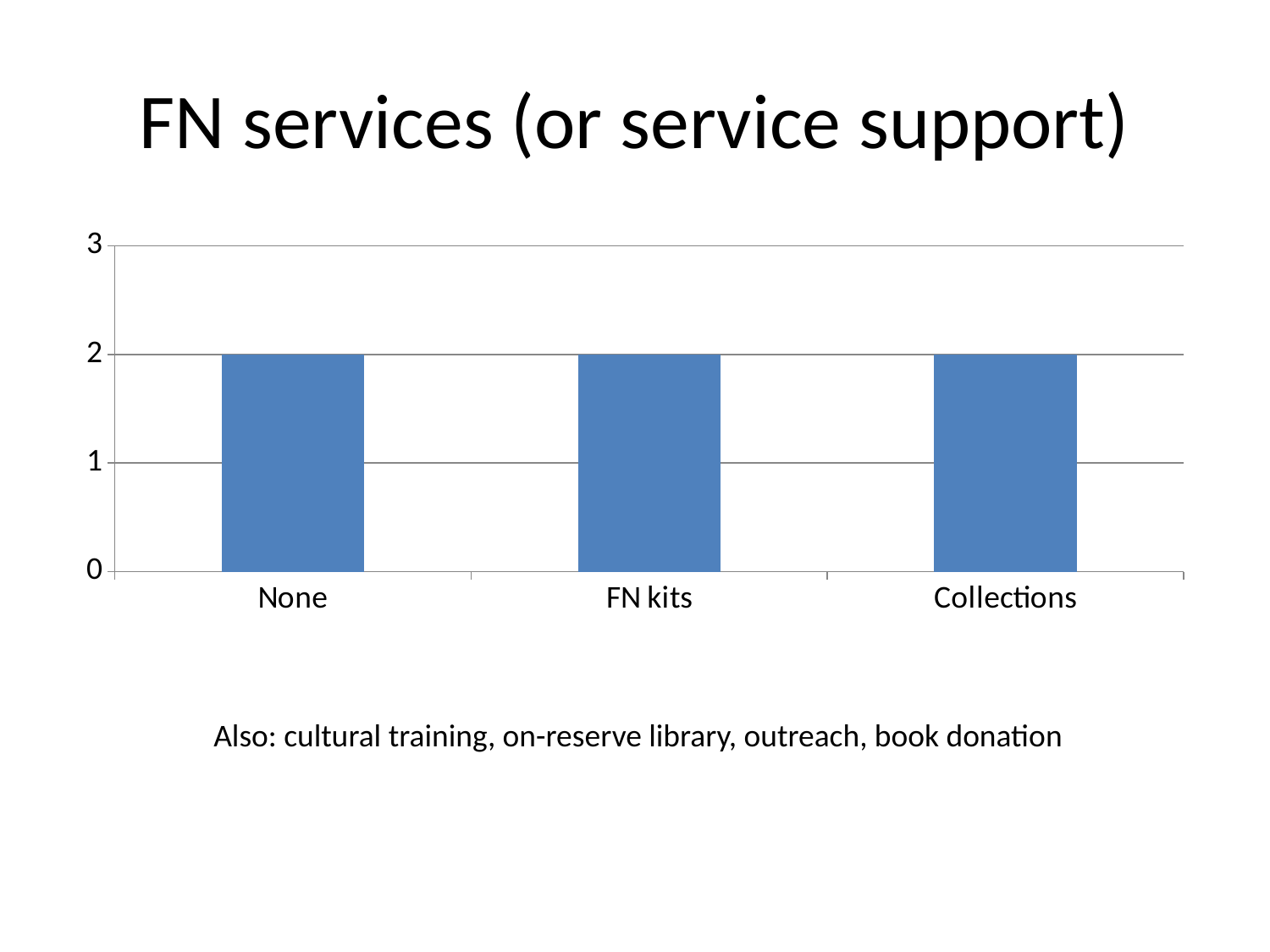
Do the values rise, fall, or stay the same from None to Collections? stay the same What is the value for None? 2 What is the value for Collections? 2 How many categories are shown on the x axis? 3 Is the value for Collections greater or less than 3? less Is the value for FN kits greater or less than 1? greater What is the value for FN kits? 2 What is the difference between the values for None and Collections? 0 What kind of chart is shown on the slide? bar chart What is the highest value shown on the y axis? 3 What is the title of the slide? FN services (or service support)